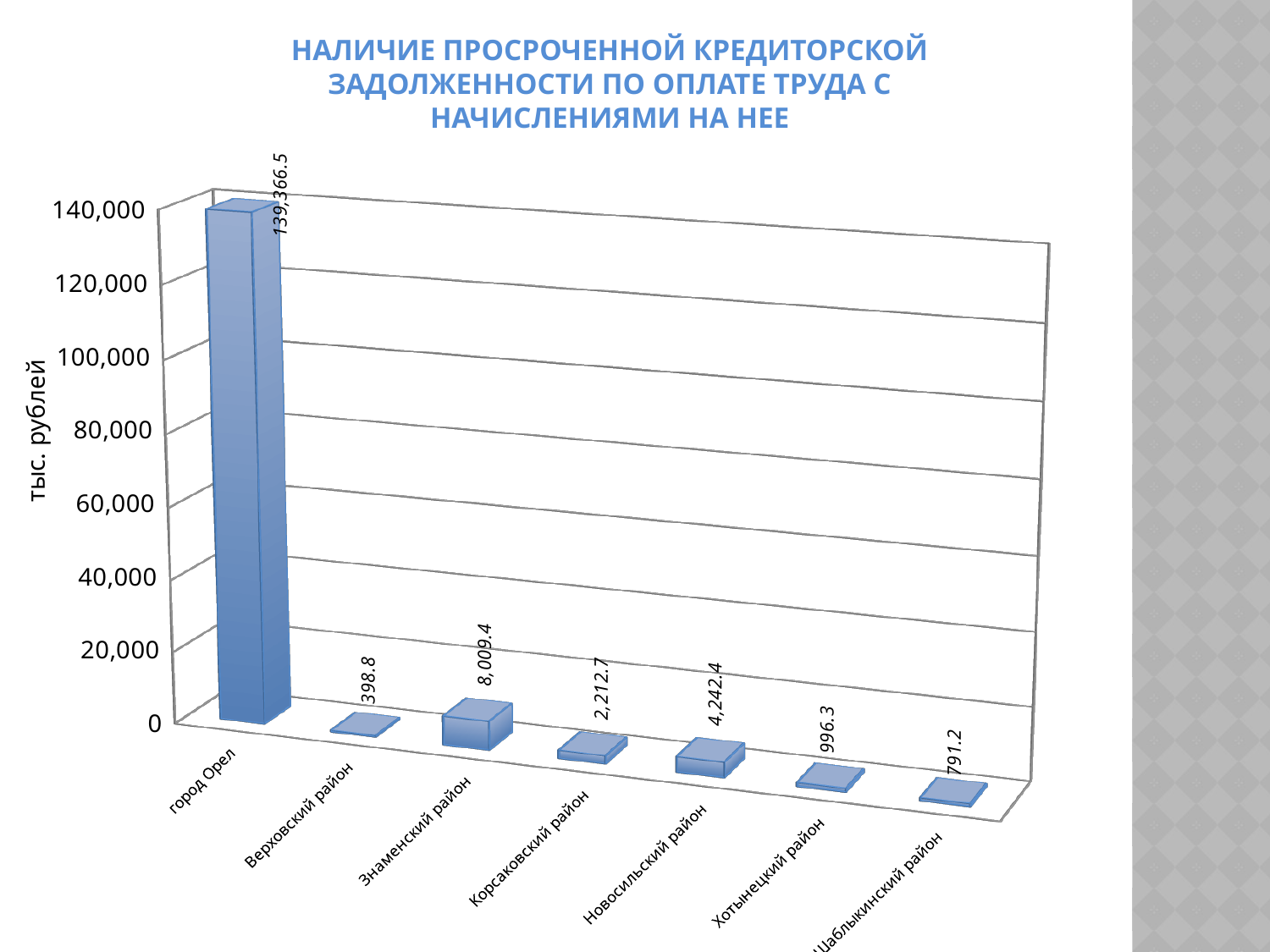
What is the label of the vertical axis? тыс. рублей What is the value for Новосильский район? 4,242.4 What is the value for город Орел? 139,366.5 How many categories are shown on the x axis? 7 Is the value for город Орел greater or less than 120,000? greater What is the value for Шаблыкинский район? 791.2 What is the difference between the values for Новосильский район and Корсаковский район? 2,029.7 Which is larger, the value for Знаменский район or the value for Новосильский район? Знаменский район Which category has the highest value? город Орел What is the value for Знаменский район? 8,009.4 Which category has the lowest value? Верховский район What is the difference between the values for Хотынецкий район and Шаблыкинский район? 205.1